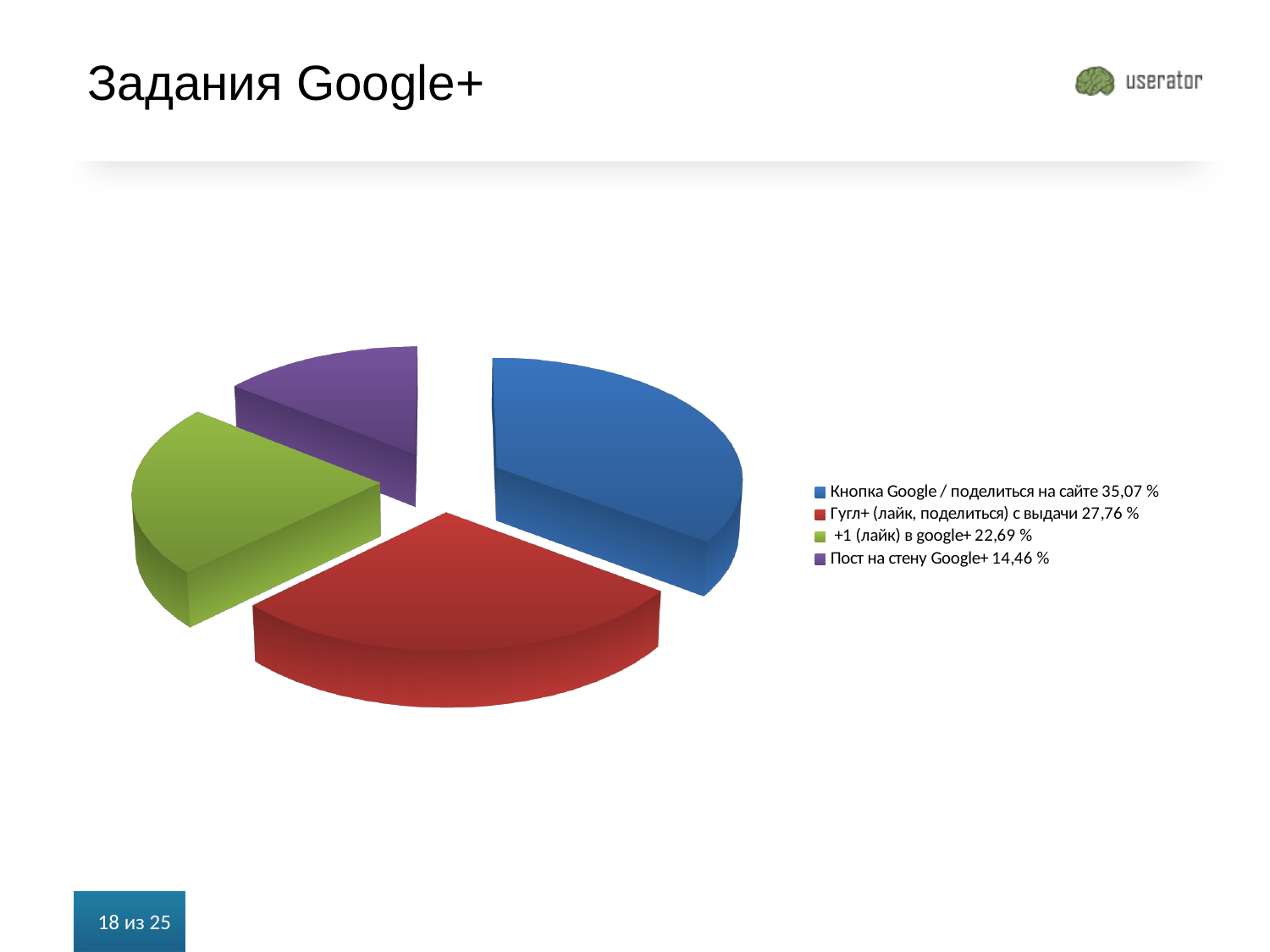
What is the difference in percentage points between "+1 (лайк) в google+" and "Пост на стену Google+"? 8,23 What kind of chart is shown on the slide? Pie chart What is the difference in percentage points between "Кнопка Google / поделиться на сайте" and "Гугл+ (лайк, поделиться) с выдачи"? 7,31 Which category has the largest share in the pie chart? Кнопка Google / поделиться на сайте Which category has the smallest share in the pie chart? Пост на стену Google+ Which is larger: the share for "Гугл+ (лайк, поделиться) с выдачи" or the share for "+1 (лайк) в google+"? Гугл+ (лайк, поделиться) с выдачи What share does "Кнопка Google / поделиться на сайте" have in the pie chart? 35,07 % What share does "Гугл+ (лайк, поделиться) с выдачи" have in the pie chart? 27,76 % What share does "Пост на стену Google+" have in the pie chart? 14,46 % What share does "+1 (лайк) в google+" have in the pie chart? 22,69 % What colour is the slice for "Пост на стену Google+" in the pie chart? Purple How many slices does the pie chart have? 4